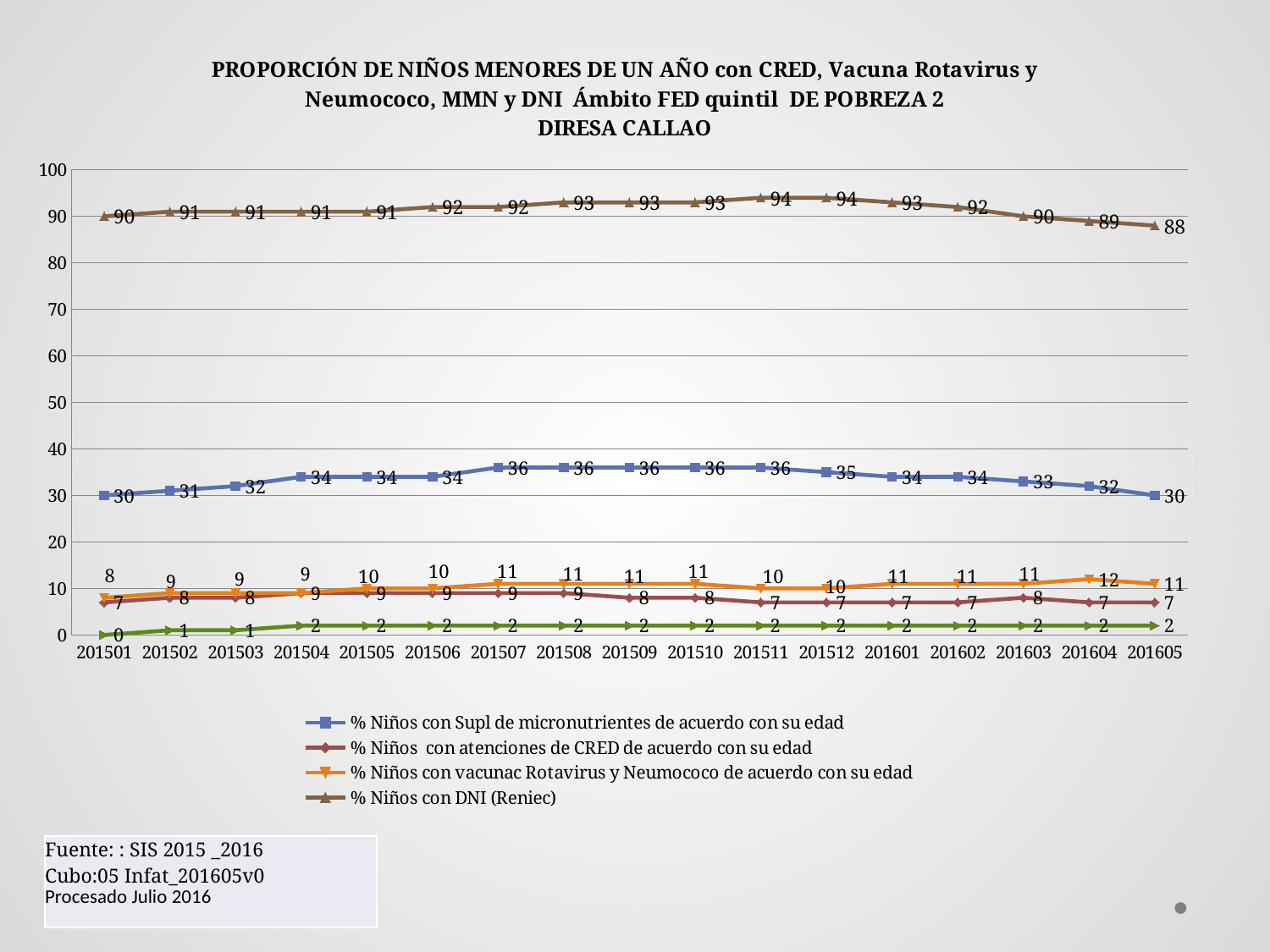
At which period does % Niños con DNI (Reniec) reach its lowest value? 201605 What is the value for % Niños con DNI (Reniec) at 201511? 94 What is the difference between the % Niños con DNI (Reniec) value at 201512 and at 201605? 6 What is the value for % Niños con vacunac Rotavirus y Neumococo de acuerdo con su edad at 201604? 12 What kind of chart is shown on the slide? Line chart What is the difference between the % Niños con Supl de micronutrientes de acuerdo con su edad value at 201507 and at 201501? 6 How many series does the legend list? 4 What is the value for % Niños con atenciones de CRED de acuerdo con su edad at 201501? 7 Which is larger at 201507: % Niños con vacunac Rotavirus y Neumococo de acuerdo con su edad or % Niños con atenciones de CRED de acuerdo con su edad? % Niños con vacunac Rotavirus y Neumococo de acuerdo con su edad Does % Niños con Supl de micronutrientes de acuerdo con su edad rise or fall from 201511 to 201605? Fall How many periods are shown on the x axis? 17 What is the value for % Niños con Supl de micronutrientes de acuerdo con su edad at 201605? 30